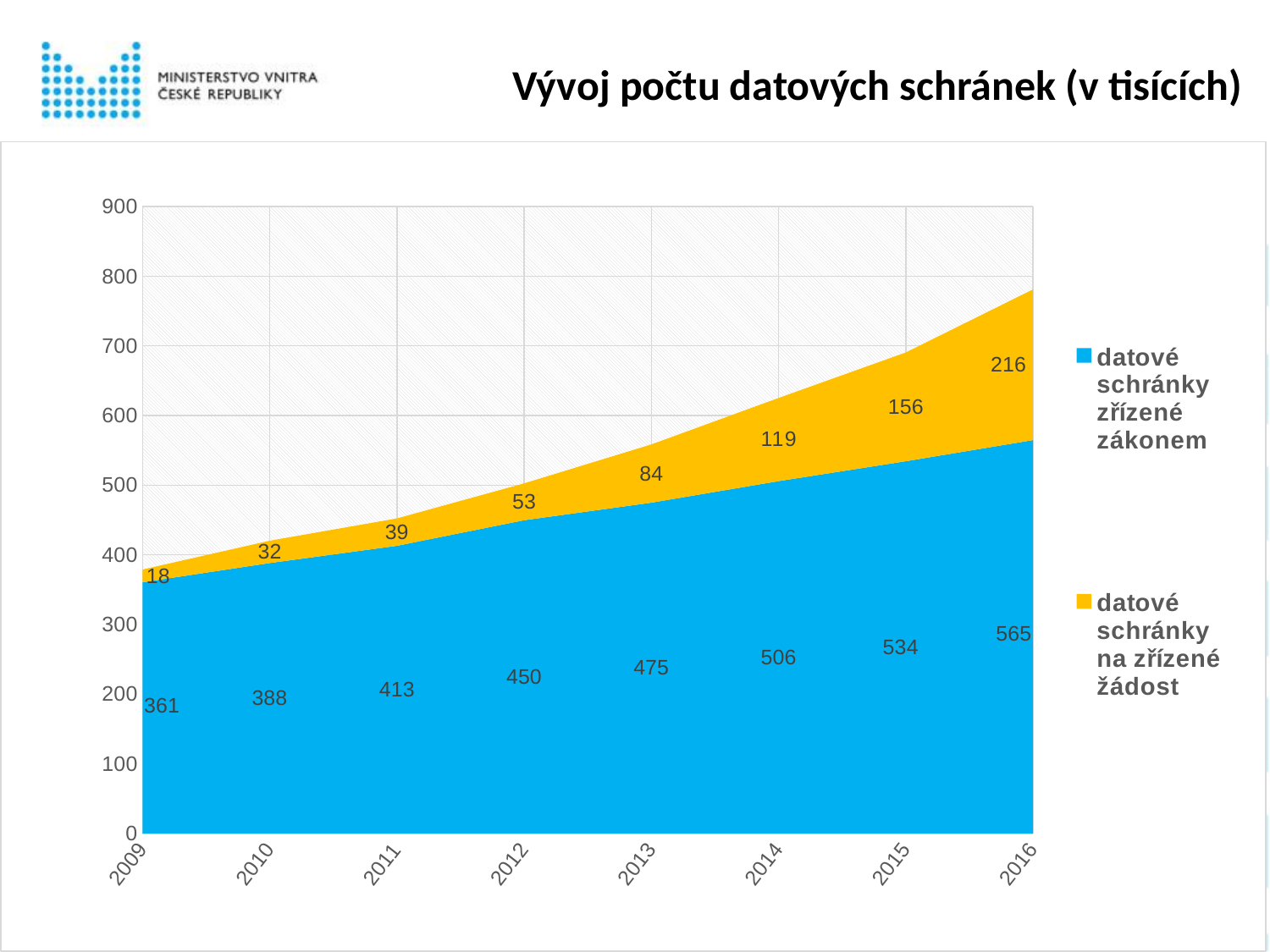
In which year is the value for 'datové schránky na zřízené žádost' highest? 2016 How many years are shown on the x axis? 8 How many series does the legend list? 2 What is the value for 'datové schránky zřízené zákonem' in 2009? 361 What is the difference between the 'datové schránky zřízené zákonem' values for 2016 and 2015? 31 What is the combined total of both series in 2016? 781 What is the value for 'datové schránky zřízené zákonem' in 2012? 450 What type of chart is shown on the slide? Stacked area chart Does the value for 'datové schránky na zřízené žádost' rise or fall from 2009 to 2016? Rise What is the value for 'datové schránky na zřízené žádost' in 2014? 119 Which is larger in 2013: 'datové schránky zřízené zákonem' or 'datové schránky na zřízené žádost'? datové schránky zřízené zákonem In which year is the value for 'datové schránky zřízené zákonem' lowest? 2009